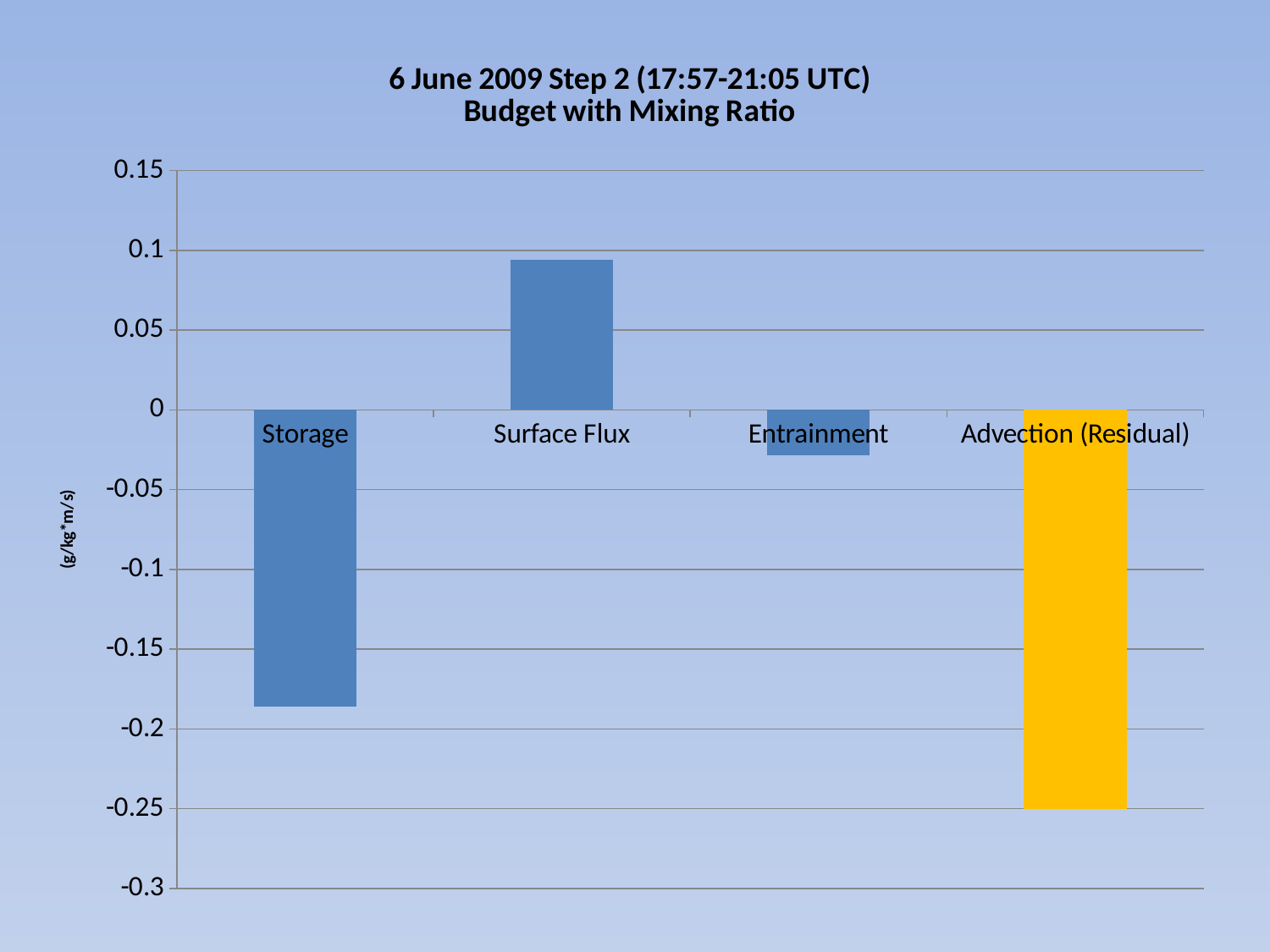
Which category has the highest value? Surface Flux How many categories are plotted in the chart? 4 Which is larger, the value for Storage or the value for Advection (Residual)? Storage What kind of chart is shown on the slide? bar chart Is the value for Entrainment greater or less than -0.05? greater What unit label is shown on the vertical axis? (g/kg*m/s) Is the value for Surface Flux greater or less than 0.05? greater Which category's bar is coloured yellow rather than blue? Advection (Residual) Is the value for Storage greater or less than -0.15? less What is the value for Advection (Residual)? -0.25 Which category has the lowest value? Advection (Residual) Which is larger, the value for Surface Flux or the value for Entrainment? Surface Flux